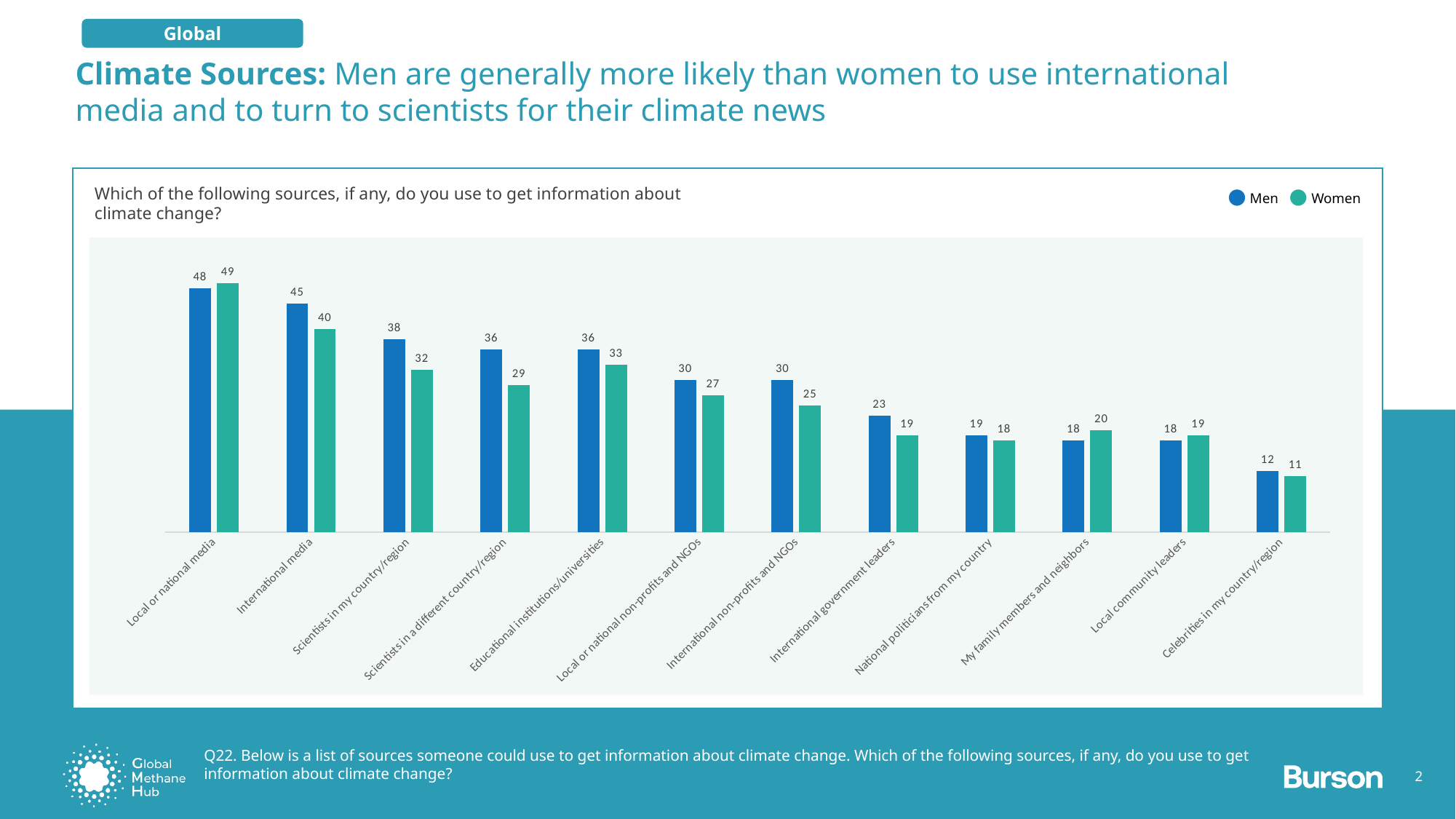
Which is larger for My family members and neighbors, the Men value or the Women value? Women What is the value for Men for International non-profits and NGOs? 30 What is the difference between the Men and Women values for Scientists in a different country/region? 7 How many series does the legend list? 2 What kind of chart is shown on the slide? Bar chart What is the value for Women for Scientists in my country/region? 32 What is the value for Men for International media? 45 Which category has the highest value for Women? Local or national media How many categories are shown on the x axis? 12 Which is larger for Educational institutions/universities, the Men value or the Women value? Men Which category has the lowest value for Men? Celebrities in my country/region Which series is shown in blue in the legend? Men